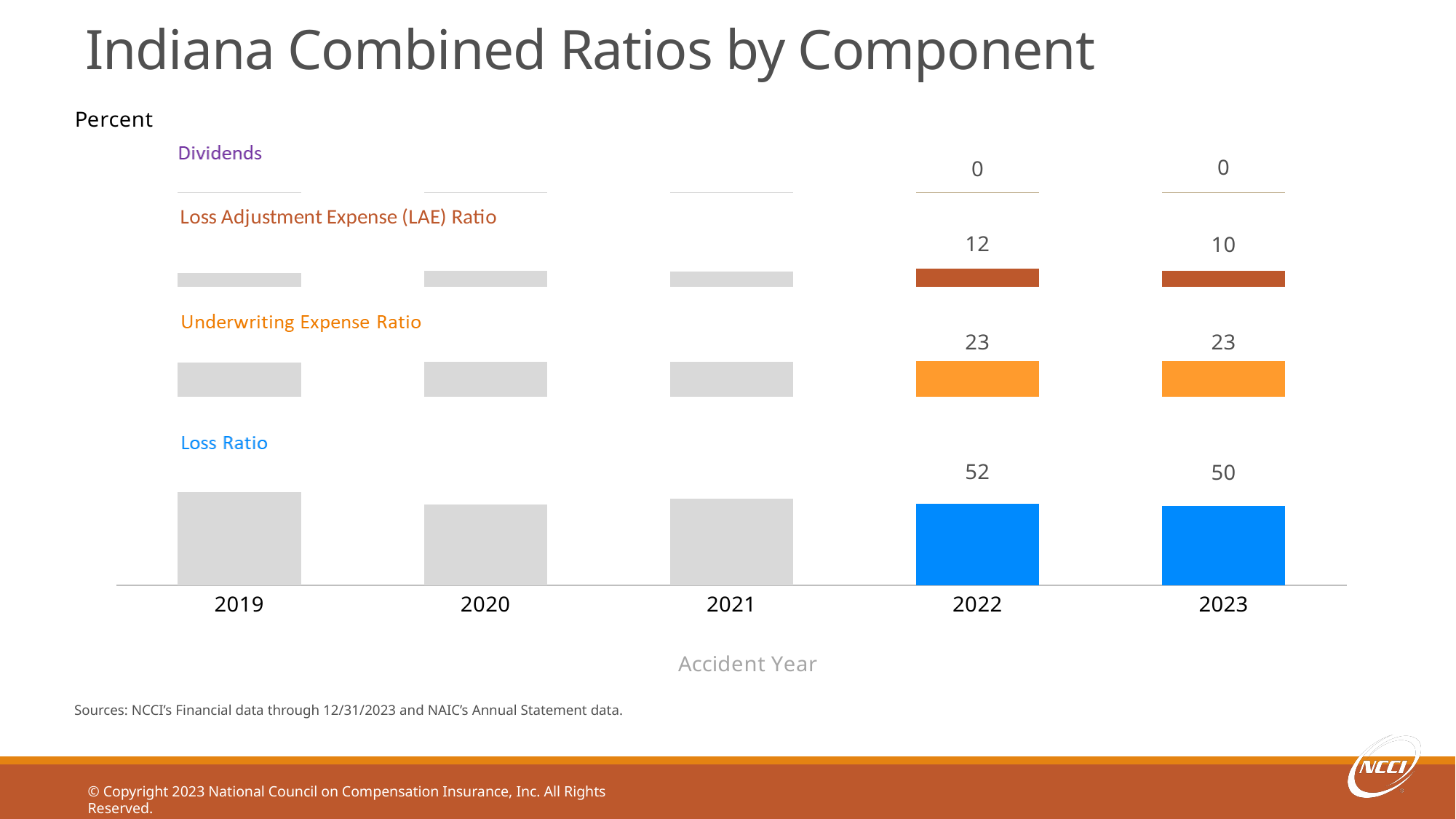
What is the Loss Ratio for accident year 2023? 50 Which year has the larger Loss Ratio, 2022 or 2023? 2022 What is the title of the x axis? Accident Year What is the Underwriting Expense Ratio for 2022? 23 What is the Loss Adjustment Expense (LAE) Ratio for 2023? 10 What is the Dividends value for 2023? 0 What is the difference between the LAE Ratio in 2022 and in 2023? 2 By how much did the Loss Ratio change from 2022 to 2023? 2 How many components (series) are shown in the chart? 4 What is the sum of the four components for accident year 2022? 87 How many accident years are shown on the x axis? 5 What is the Loss Ratio for accident year 2022? 52